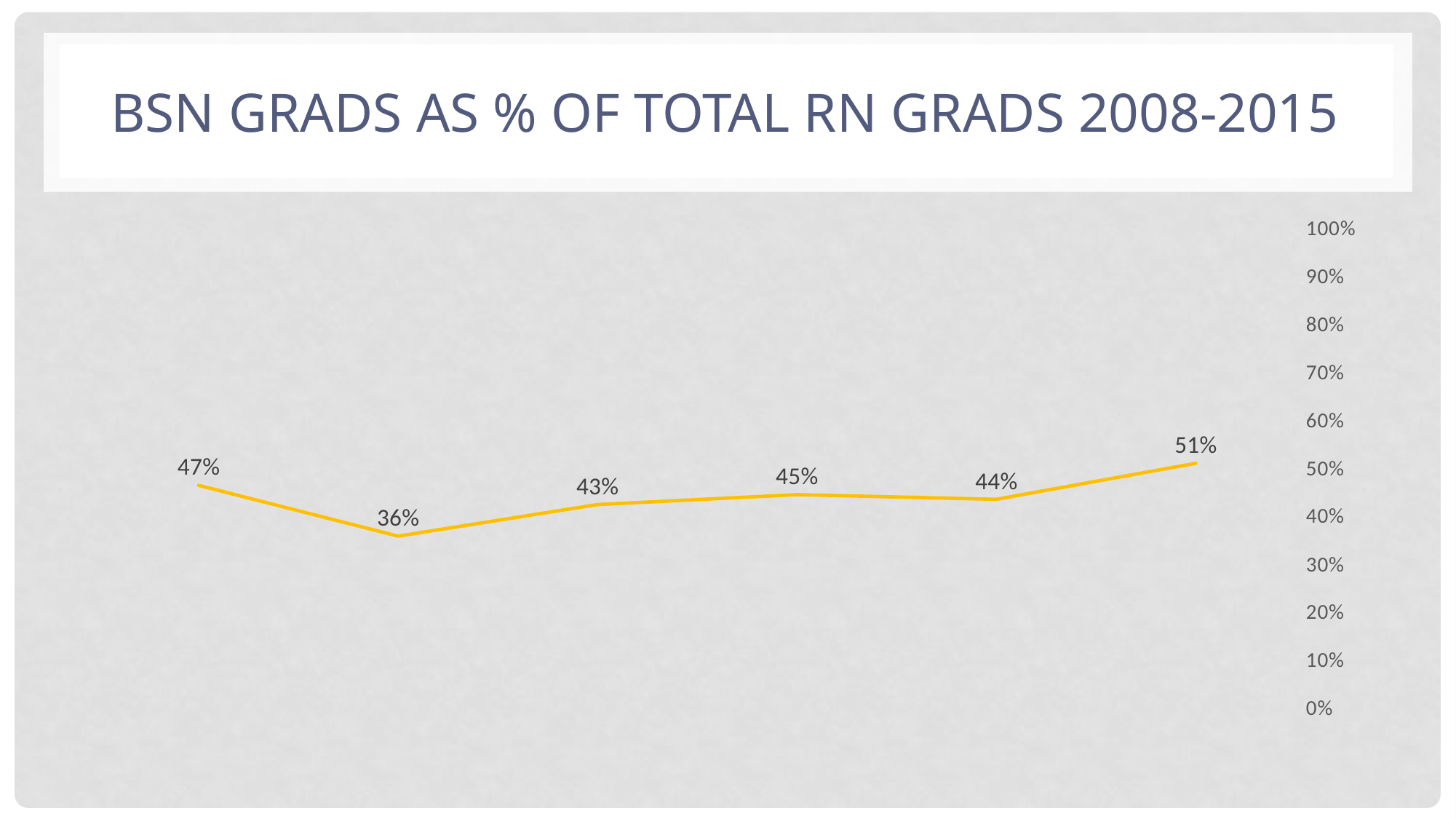
What is the lowest value plotted on the line? 36% Which is larger, the fourth data point or the fifth data point? the fourth (45%) How many data points are plotted on the line? 6 What is the title of the chart? BSN GRADS AS % OF TOTAL RN GRADS 2008-2015 What is the difference between the first data point (47%) and the second data point (36%)? 11% What is the difference between the highest and lowest values on the line? 15% What is the value of the first (leftmost) data point? 47% What is the highest value plotted on the line? 51% What is the value of the second data point from the left? 36% Is the value of the last data point greater or less than 50%? greater What kind of chart is shown on the slide? line chart What is the value of the last (rightmost) data point? 51%